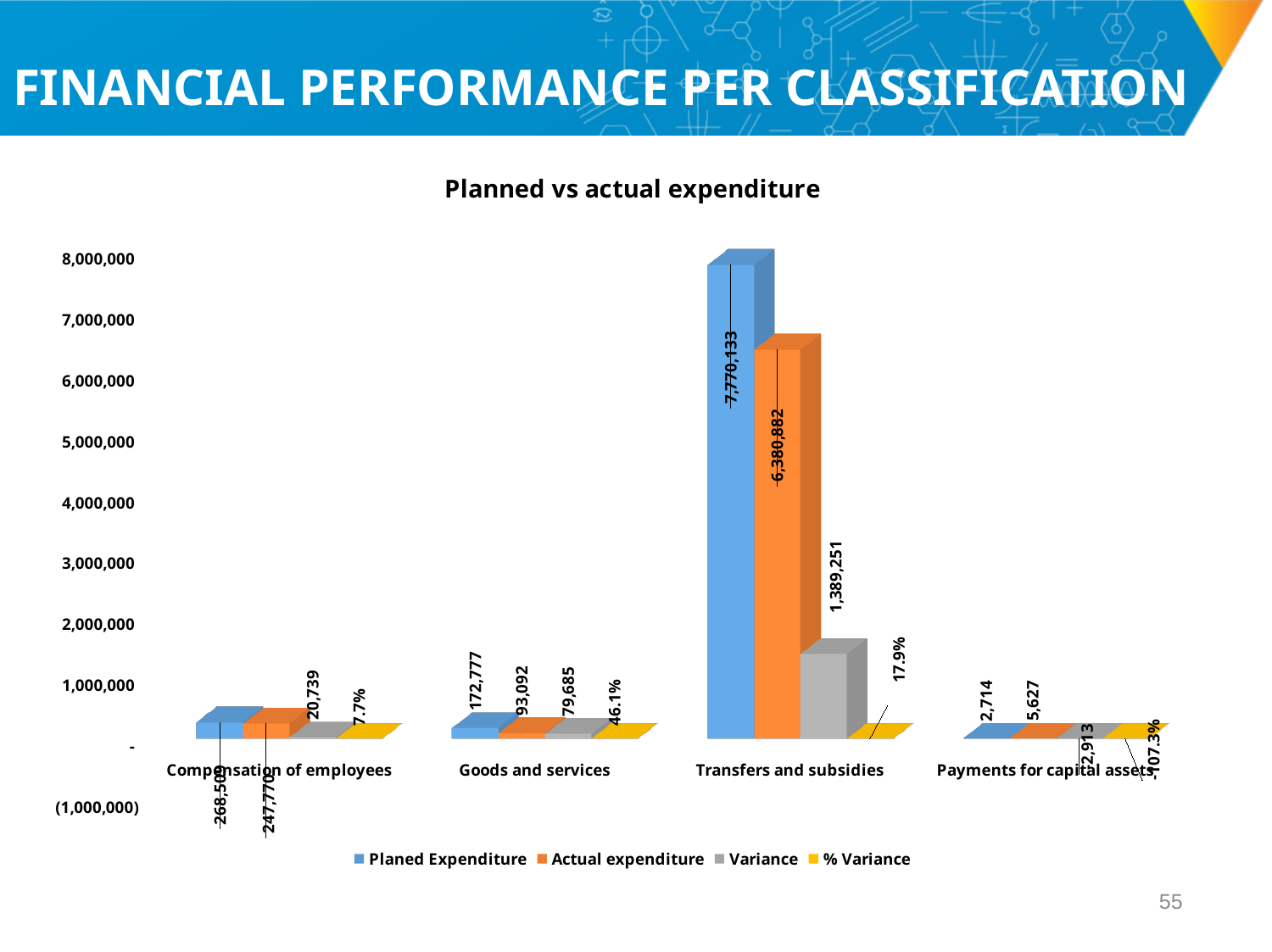
What type of chart is shown on the slide? bar chart Which category has the highest Planed Expenditure? Transfers and subsidies Which category has the lowest Actual expenditure? Payments for capital assets What is the Actual expenditure value for Transfers and subsidies? 6,380,882 What is the % Variance for Payments for capital assets? -107.3% What is the difference between Planed Expenditure and Actual expenditure for Goods and services? 79,685 What is the Variance value for Goods and services? 79,685 How many series does the legend list? 4 What is the title of the chart? Planned vs actual expenditure How many categories are shown on the x axis? 4 What is the Planed Expenditure value for Transfers and subsidies? 7,770,133 Which is larger for Payments for capital assets: Planed Expenditure or Actual expenditure? Actual expenditure